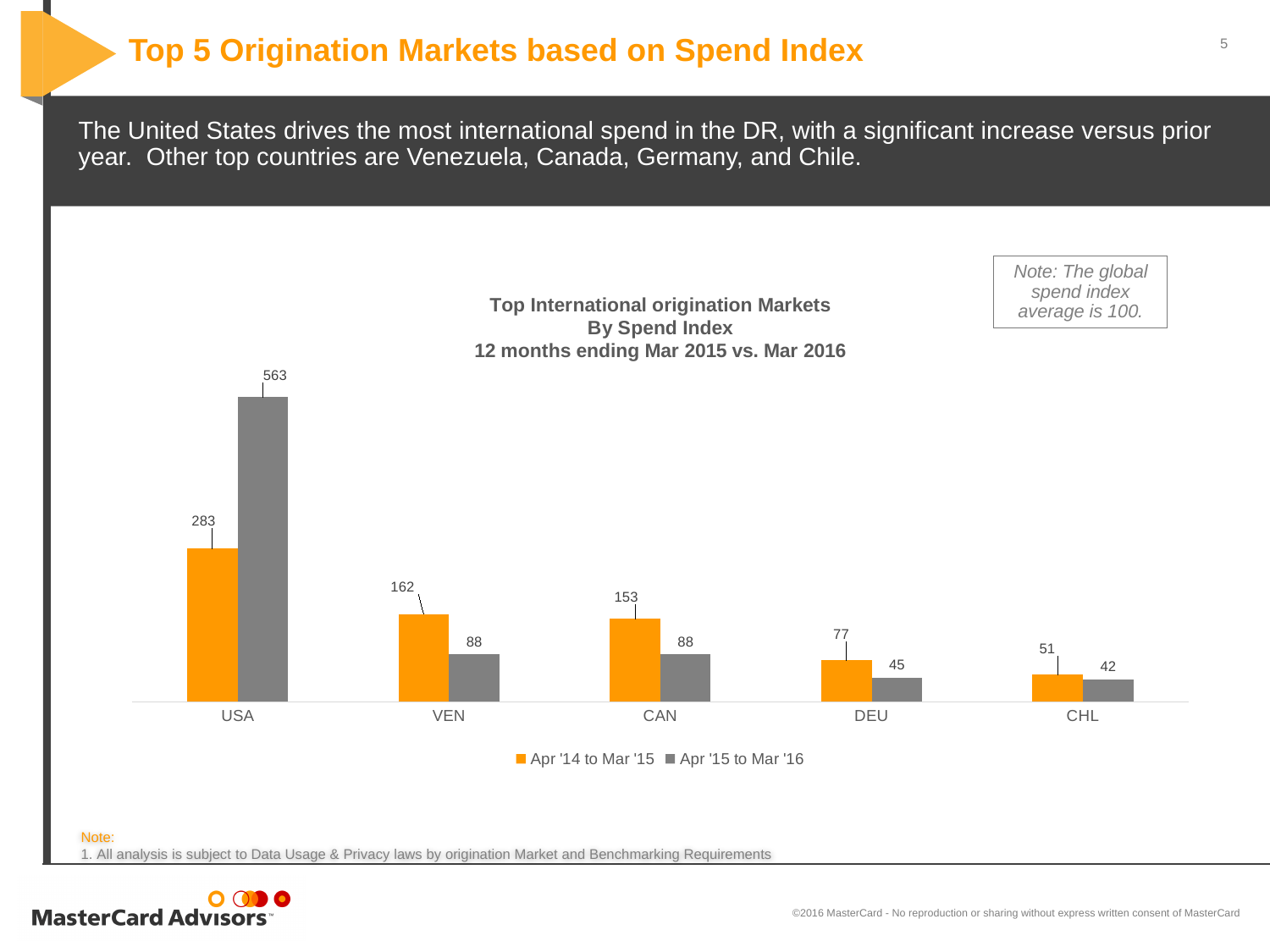
What colour represents the Apr '14 to Mar '15 series in the legend? Orange How many origination markets are shown on the chart? 5 Which market has the lowest spend index in the Apr '14 to Mar '15 period? CHL Which is larger: the CAN spend index for Apr '14 to Mar '15 or the VEN spend index for Apr '14 to Mar '15? VEN What is the spend index for VEN in the Apr '14 to Mar '15 period? 162 What is the difference between the USA spend index for Apr '15 to Mar '16 and Apr '14 to Mar '15? 280 What kind of chart is shown on the slide? Bar chart What is the spend index for DEU in the Apr '15 to Mar '16 period? 45 What is the spend index for USA in the Apr '15 to Mar '16 period? 563 Do the Apr '15 to Mar '16 values rise or fall from USA to CHL along the x axis? Fall How many series does the legend list? 2 Which market has the highest spend index in the Apr '15 to Mar '16 period? USA